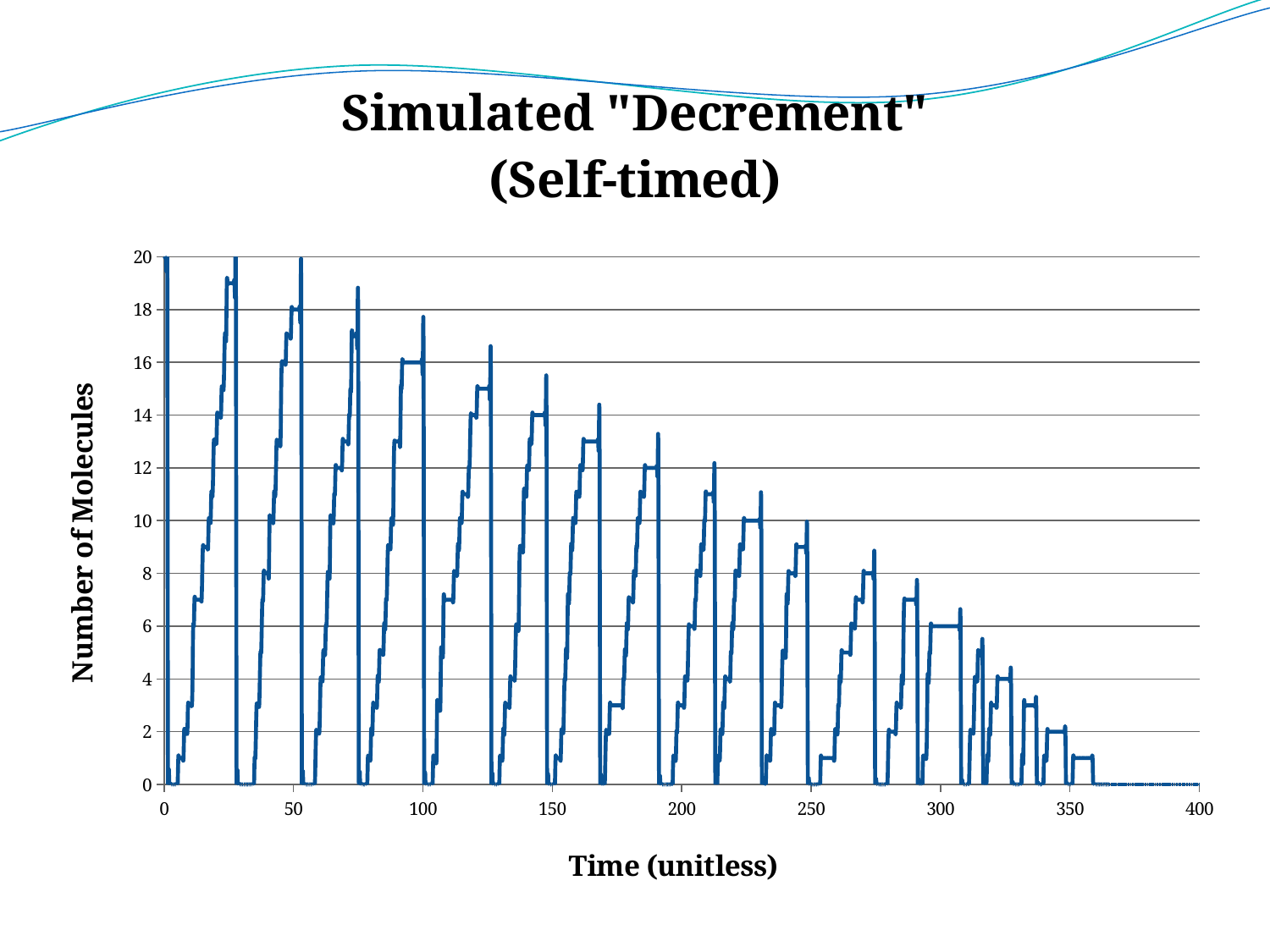
Is the peak of the line near time 350 greater or less than 4? less What is the title of the chart? Simulated "Decrement" (Self-timed) Is the peak of the line near time 100 greater or less than 14? greater Is the peak of the line near time 250 greater or less than 14? less What is the highest value shown on the vertical axis? 20 Which is larger, the peak of the line near time 25 or the peak near time 300? the peak near time 25 Do the peaks of the line rise or fall as time increases along the x axis? fall What is the label of the vertical axis? Number of Molecules What is the value of the line at time 400? 0 What kind of chart is shown on the slide? line chart